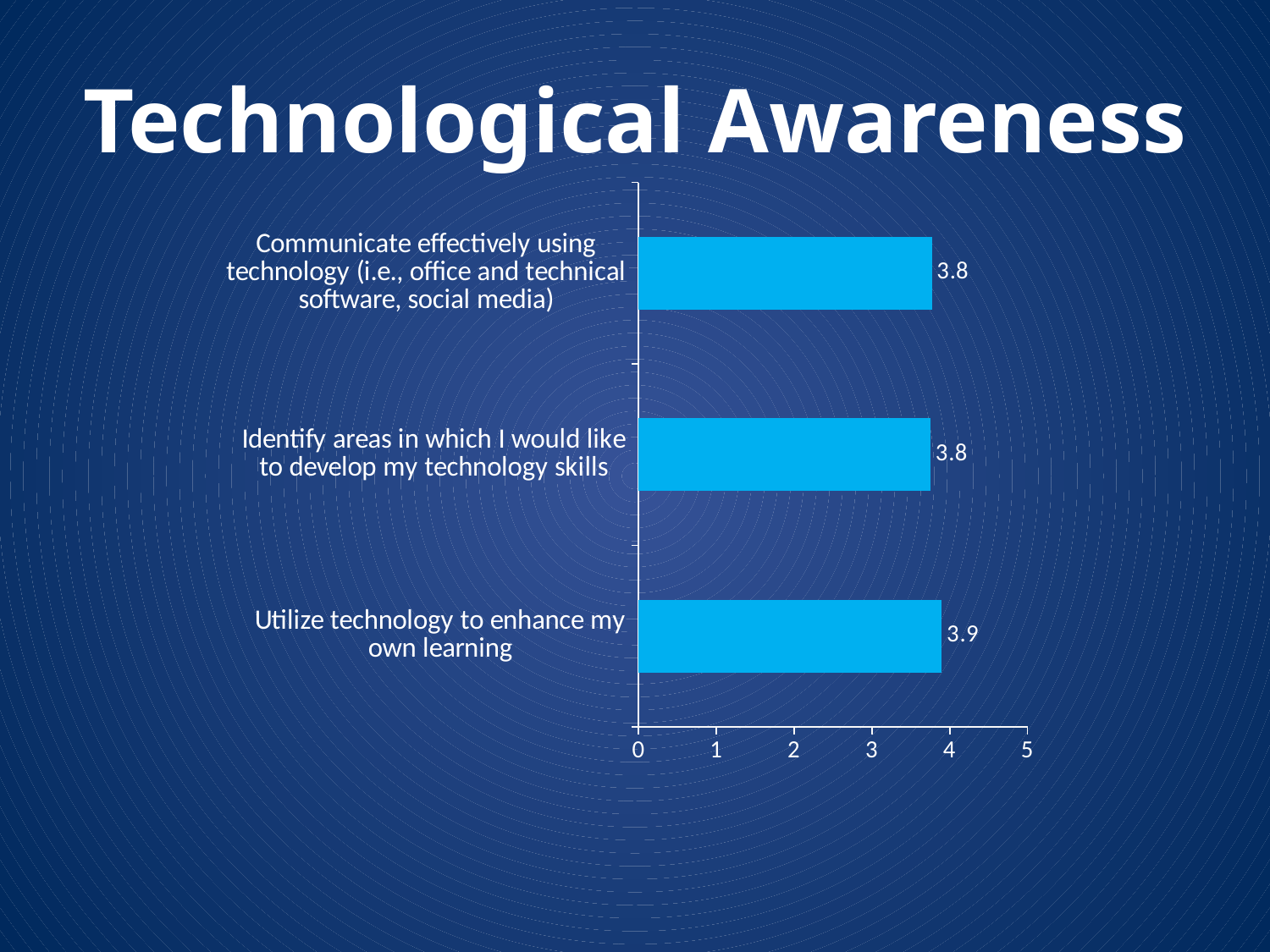
What is the value for "Identify areas in which I would like to develop my technology skills"? 3.8 Is the value for "Communicate effectively using technology (i.e., office and technical software, social media)" greater or less than 4? less Which category has the highest value? Utilize technology to enhance my own learning What is the value for "Communicate effectively using technology (i.e., office and technical software, social media)"? 3.8 What is the value for "Utilize technology to enhance my own learning"? 3.9 How many categories are shown in the chart? 3 What kind of chart is shown on the slide? Bar chart What is the title of the slide? Technological Awareness What is the difference between the value for "Utilize technology to enhance my own learning" and the value for "Identify areas in which I would like to develop my technology skills"? 0.1 What is the maximum value shown on the horizontal axis? 5 Is the value for "Utilize technology to enhance my own learning" greater or less than 3? greater